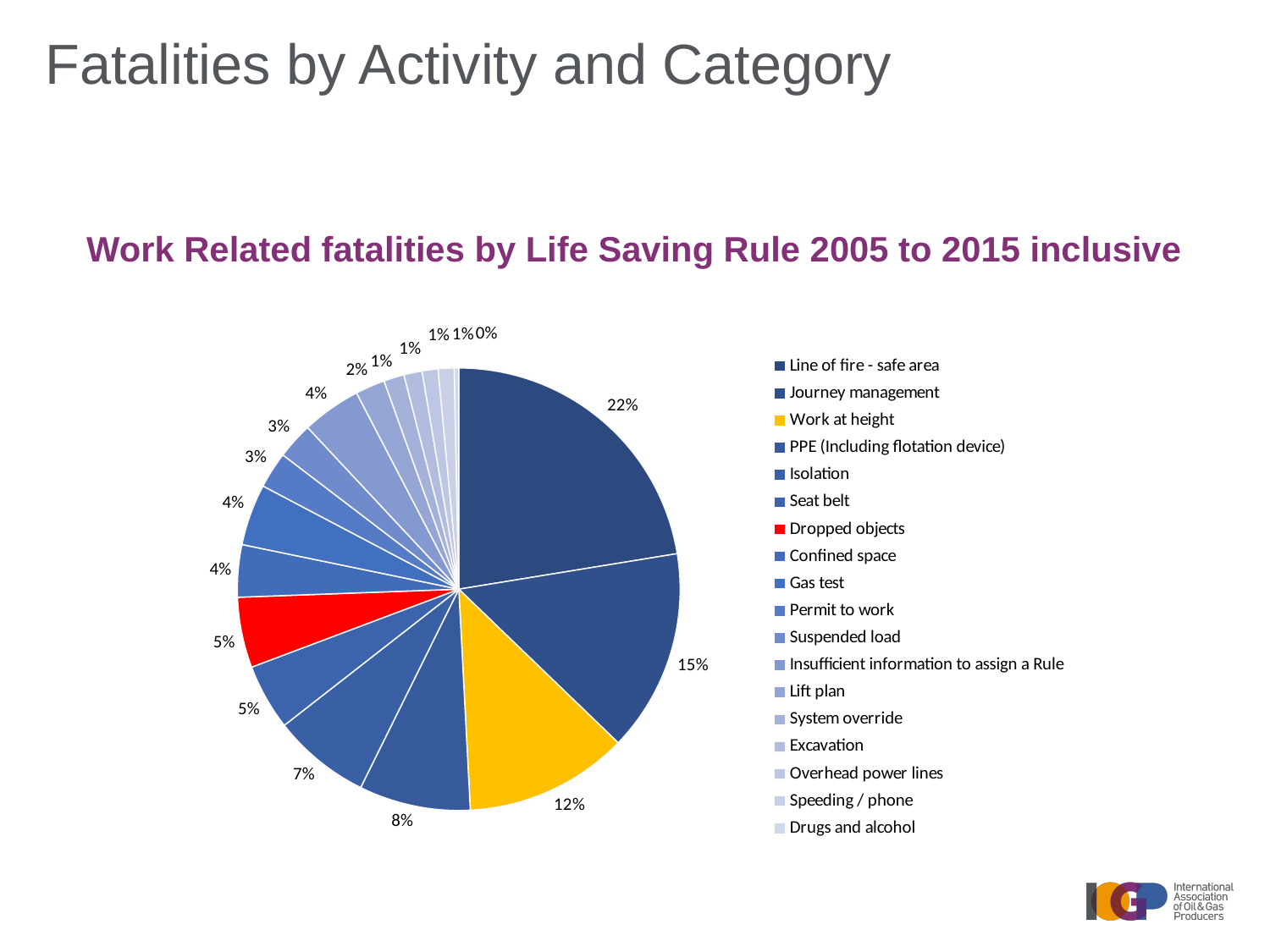
What is the title of the chart? Work Related fatalities by Life Saving Rule 2005 to 2015 inclusive Which Life Saving Rule accounts for the smallest share of fatalities? Drugs and alcohol What type of chart is shown on the slide? Pie chart What colour is the slice for Dropped objects? Red What is the difference in percentage points between Line of fire - safe area and Journey management? 7 percentage points Which has a larger share of fatalities, Work at height or PPE (Including flotation device)? Work at height Which Life Saving Rule accounts for the largest share of fatalities? Line of fire - safe area What share of work related fatalities is attributed to Line of fire - safe area? 22% What percentage of fatalities is attributed to Dropped objects? 5% What percentage of fatalities is attributed to Journey management? 15% What percentage of fatalities is attributed to Work at height? 12% How many Life Saving Rule categories are listed in the legend? 18